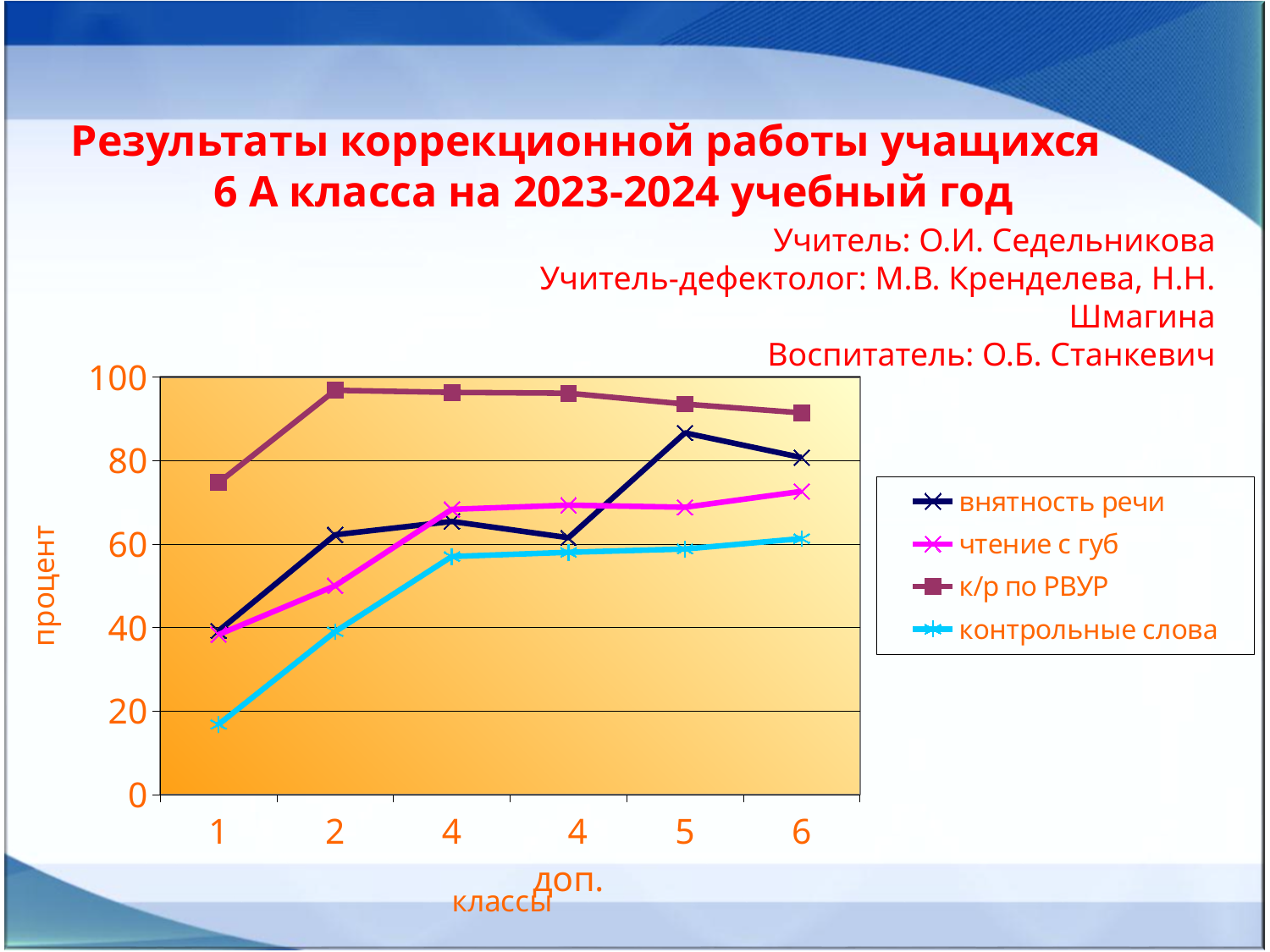
How many series does the legend list? 4 Is the value for внятность речи at class 5 greater or less than 80? greater Do the values for контрольные слова rise or fall from class 1 to class 6? rise How many points are there along the x axis (классы)? 6 What is the title of the vertical axis? процент Is the value for к/р по РВУР at class 2 greater or less than 80? greater Which series has the lowest value at class 1? контрольные слова At class 5, which is larger: внятность речи or чтение с губ? внятность речи Is the value for контрольные слова at class 1 greater or less than 20? less What kind of chart is shown on the slide? line chart Which series has the highest value at class 6? к/р по РВУР